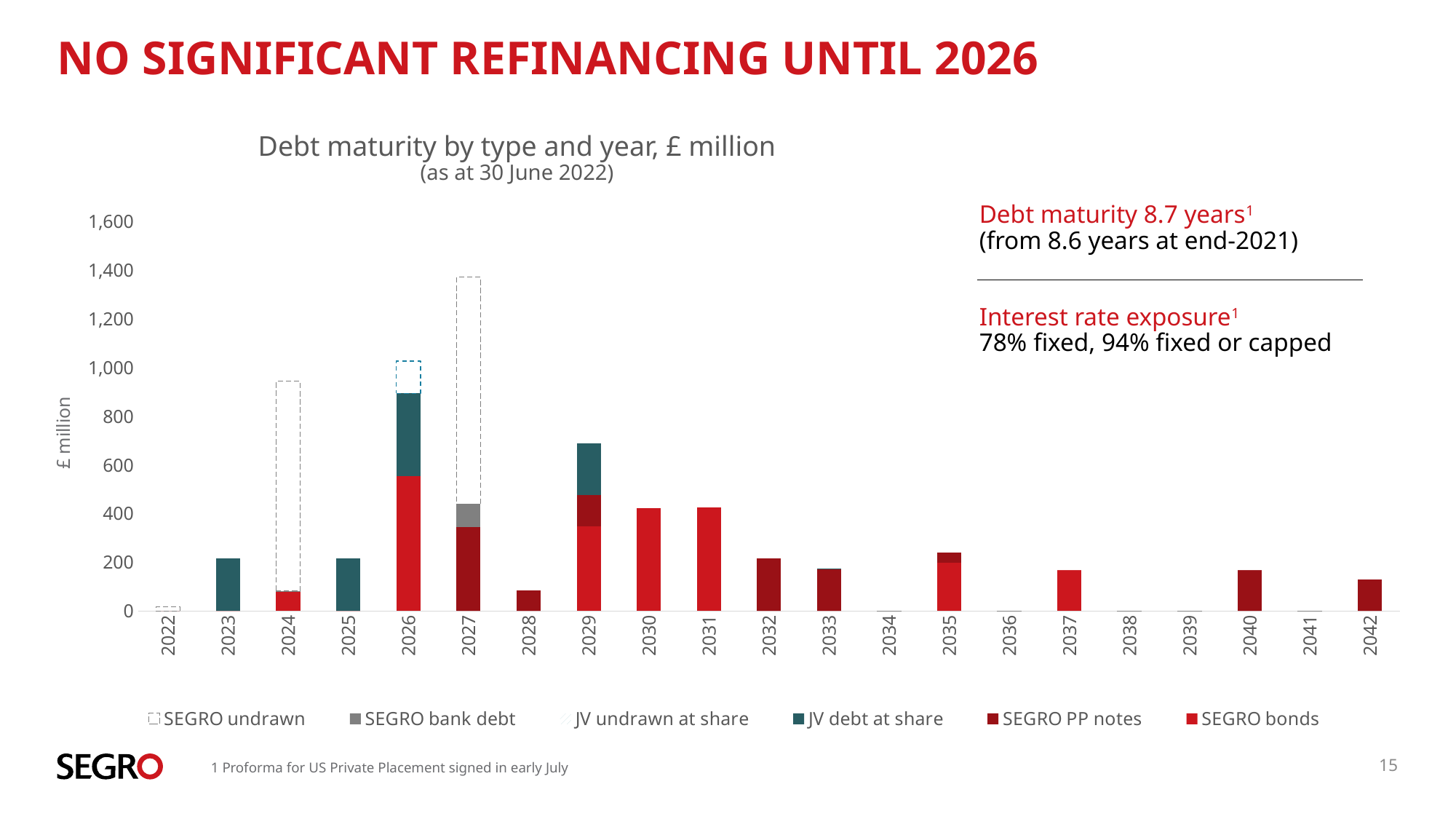
Is the total value for 2029 greater or less than 600? greater Which legend series is shown with a dashed outline? SEGRO undrawn Is the total value for 2027 including the undrawn portion greater or less than 1,200? greater What kind of chart is shown on the slide? Bar chart Is the total value for 2026 (including undrawn) greater or less than 800? greater What is the title of the chart? Debt maturity by type and year, £ million (as at 30 June 2022) Which year has the larger total, 2028 or 2042? 2042 How many series does the legend list? 6 Which year has the larger total debt maturing, 2029 or 2030? 2029 How many years are shown on the x axis of the chart? 21